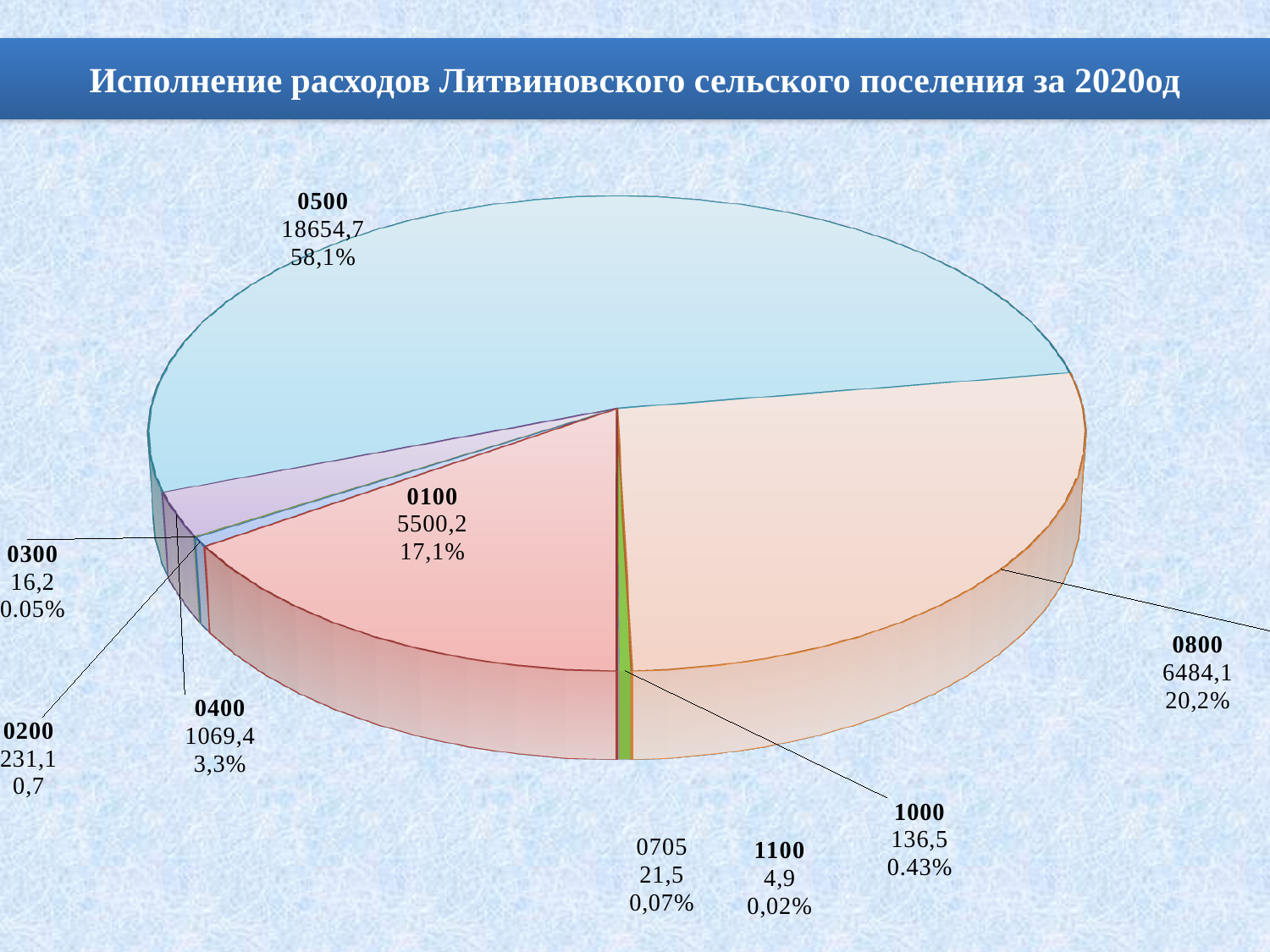
What is the value shown for category 0100? 5500,2 What share of the pie does category 0400 represent? 3,3% Which category has the largest slice of the pie? 0500 Which category has the smallest slice of the pie? 1100 What is the title of the chart on the slide? Исполнение расходов Литвиновского сельского поселения за 2020од What is the value shown for category 0500? 18654,7 Which is larger, the value for 0800 or the value for 0100? 0800 What is the value shown for category 1000? 136,5 What kind of chart is shown on the slide? pie chart What is the difference between the values for 0800 and 0100? 983,9 What share of the pie does category 0800 represent? 20,2% How many categories are shown in the pie chart? 9